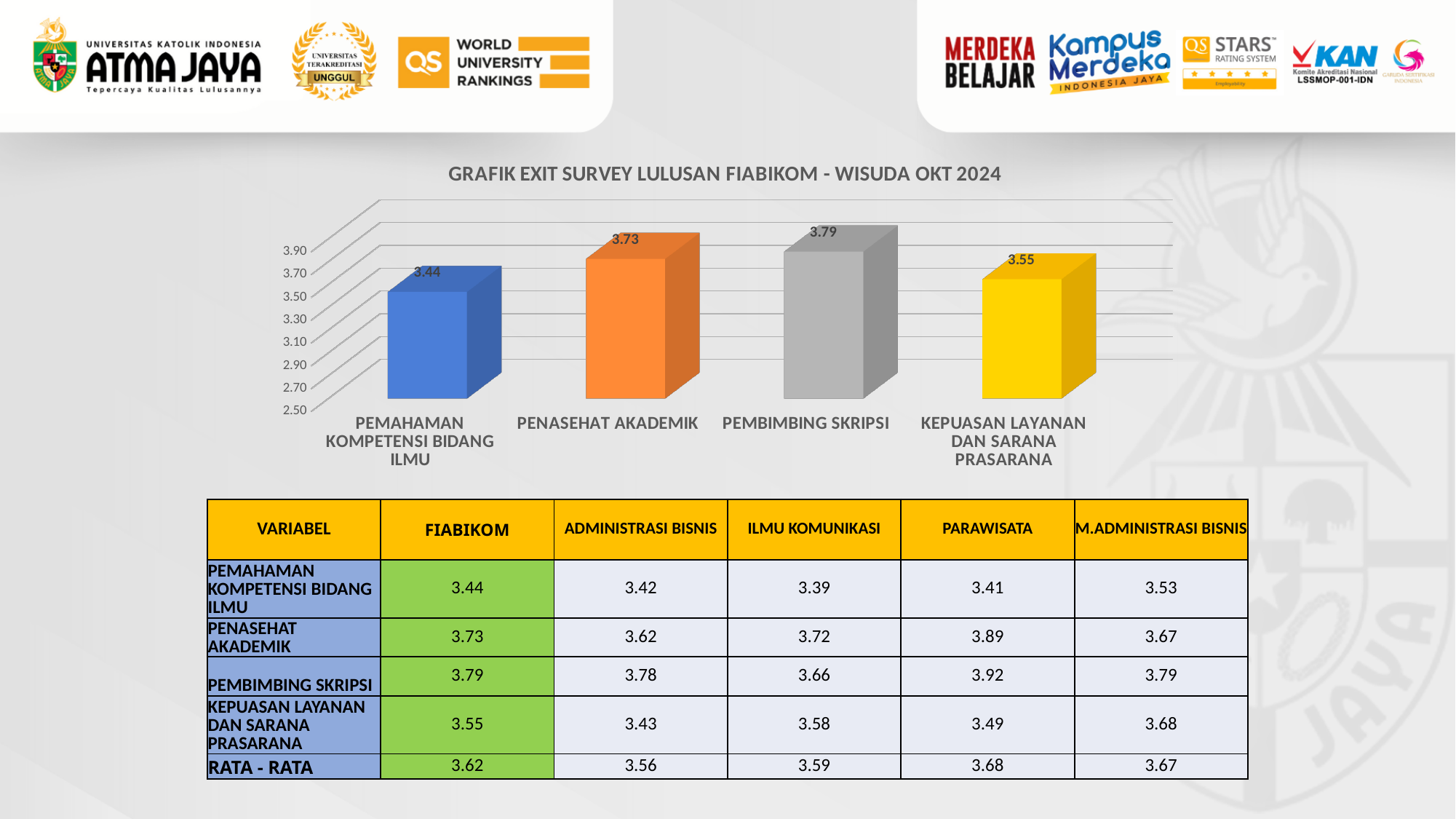
Which category has the lowest value in the chart? PEMAHAMAN KOMPETENSI BIDANG ILMU Which is larger, the value for PENASEHAT AKADEMIK or the value for KEPUASAN LAYANAN DAN SARANA PRASARANA? PENASEHAT AKADEMIK What is the difference between the values for PENASEHAT AKADEMIK and PEMAHAMAN KOMPETENSI BIDANG ILMU? 0.29 How many categories are shown in the chart? 4 What is the value for KEPUASAN LAYANAN DAN SARANA PRASARANA in the chart? 3.55 What is the value for PEMAHAMAN KOMPETENSI BIDANG ILMU in the chart? 3.44 Which category has the highest value in the chart? PEMBIMBING SKRIPSI What is the value for PEMBIMBING SKRIPSI in the chart? 3.79 What colour is the bar for PENASEHAT AKADEMIK? orange What is the title of the chart? GRAFIK EXIT SURVEY LULUSAN FIABIKOM - WISUDA OKT 2024 What kind of chart is shown on the slide? bar chart Is the value for PEMAHAMAN KOMPETENSI BIDANG ILMU greater or less than 3.50? less